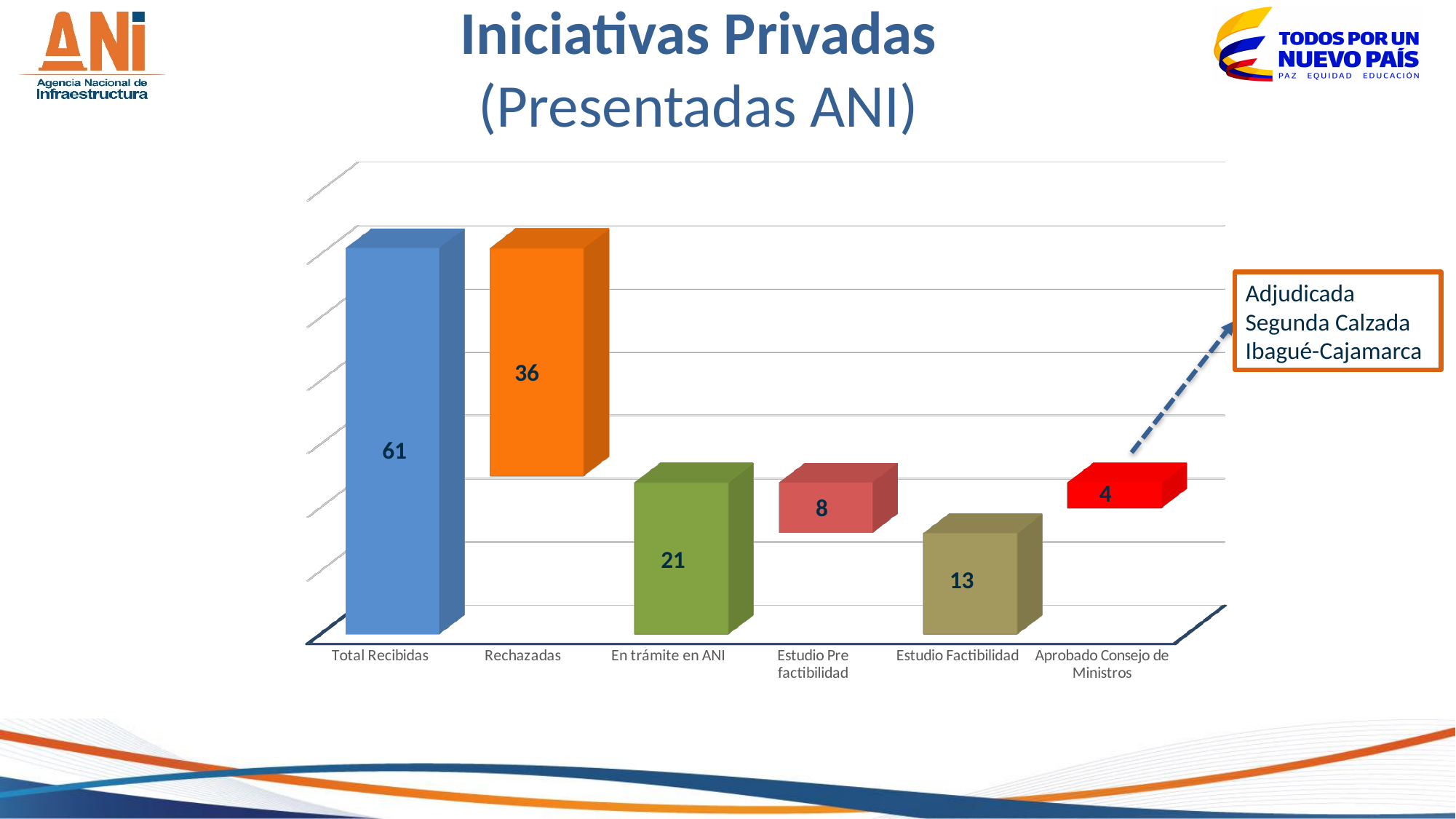
What is the value for Estudio Pre factibilidad? 8 What is the value for Total Recibidas? 61 What is the value for Aprobado Consejo de Ministros? 4 How many categories are shown on the x axis? 6 What is the value for Rechazadas? 36 What kind of chart is shown on the slide? Bar chart What is the difference between Total Recibidas and Rechazadas? 25 What does the text box with the arrow pointing to the Aprobado Consejo de Ministros bar say? Adjudicada Segunda Calzada Ibagué-Cajamarca Which category has the lowest value? Aprobado Consejo de Ministros What is the value for En trámite en ANI? 21 Which is larger, Estudio Factibilidad or Estudio Pre factibilidad? Estudio Factibilidad Which category has the highest value? Total Recibidas